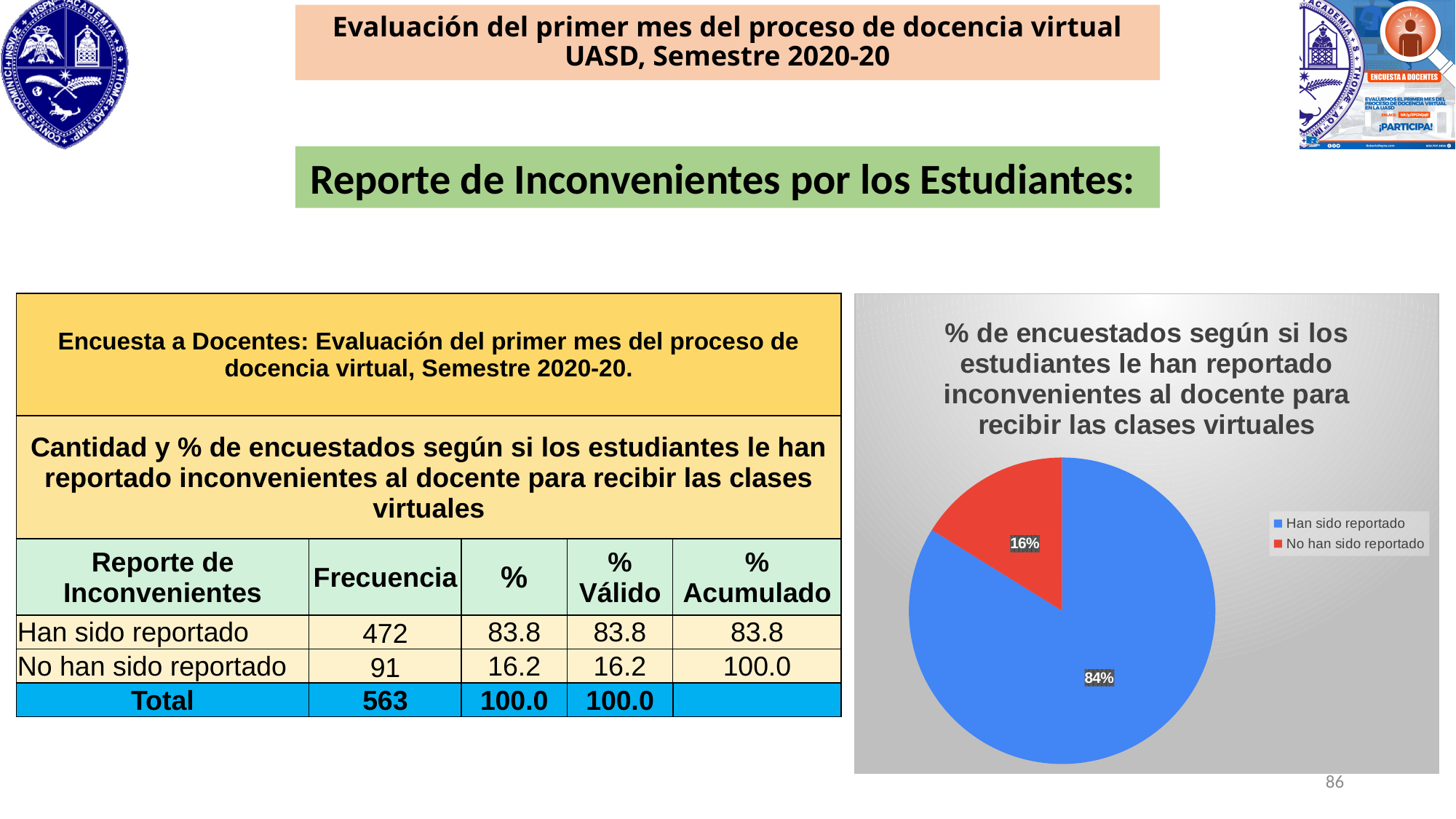
Which category has the smallest slice in the pie chart? No han sido reportado What is the title of the pie chart? % de encuestados según si los estudiantes le han reportado inconvenientes al docente para recibir las clases virtuales What percentage does the pie chart show for "No han sido reportado"? 16% What kind of chart is shown on the slide? pie chart Which is larger in the pie chart, "Han sido reportado" or "No han sido reportado"? Han sido reportado How many entries does the legend of the pie chart list? 2 How many slices does the pie chart have? 2 What colour is the "No han sido reportado" slice in the pie chart? red What percentage does the pie chart show for "Han sido reportado"? 84% What is the difference in percentage points between the "Han sido reportado" and "No han sido reportado" slices? 68% Which category has the largest slice in the pie chart? Han sido reportado